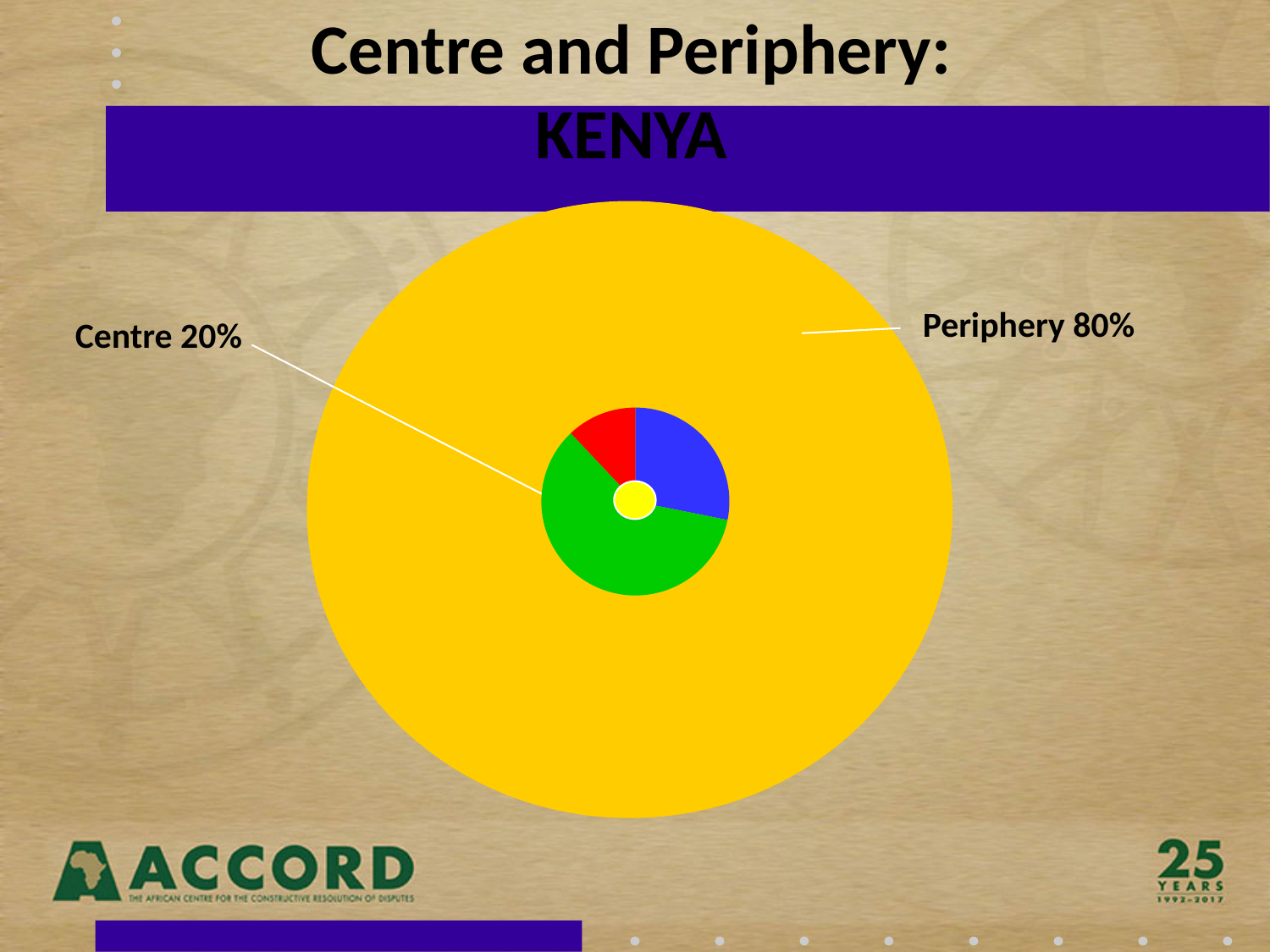
What colour is the large outer area labelled Periphery 80%? yellow How many labelled parts does the chart show? 2 What percentage is shown for Centre? 20% What kind of chart is shown on the slide? pie chart Is the value for Centre larger or smaller than the value for Periphery? smaller What is the difference in percentage points between Periphery and Centre? 60 Which of the two labelled parts, Centre or Periphery, has the smaller percentage? Centre Which country does the chart on the slide refer to? Kenya What do the Centre and Periphery percentages add up to? 100% Which of the two labelled parts, Centre or Periphery, has the larger percentage? Periphery What percentage is shown for Periphery? 80%